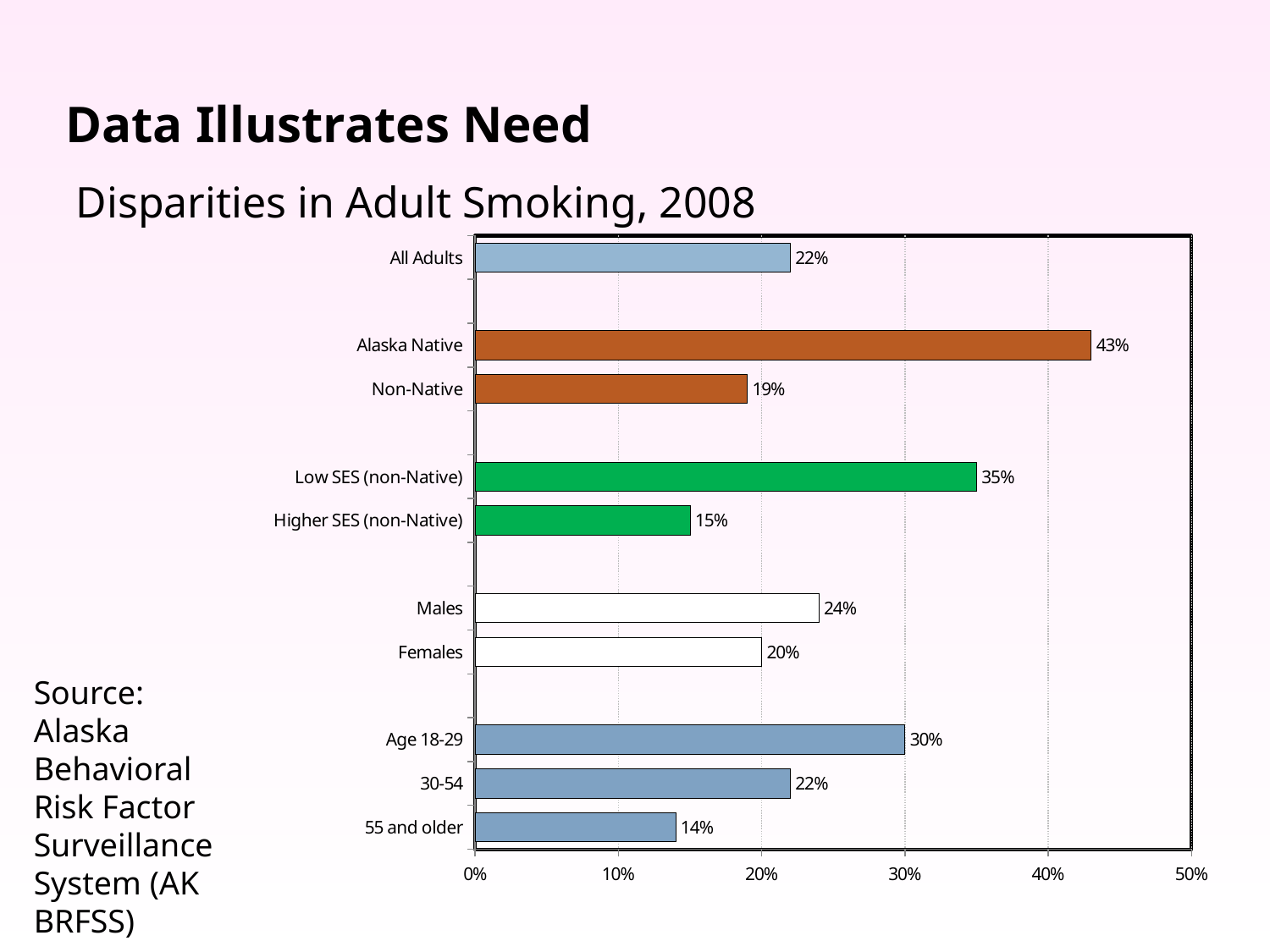
Is the value for Age 18-29 greater or less than 20%? greater How many categories are plotted in the chart? 10 What is the smoking rate for adults aged 55 and older? 14% Which has a higher smoking rate, Males or Females? Males What kind of chart is shown on the slide? bar chart What is the smoking rate for Alaska Native adults? 43% What is the title of the chart? Disparities in Adult Smoking, 2008 Which category has the lowest smoking rate? 55 and older Which category has the highest smoking rate? Alaska Native What is the difference in smoking rate between Low SES (non-Native) and Higher SES (non-Native) adults? 20% What is the smoking rate for Higher SES (non-Native) adults? 15% What is the difference in smoking rate between Alaska Native and Non-Native adults? 24%